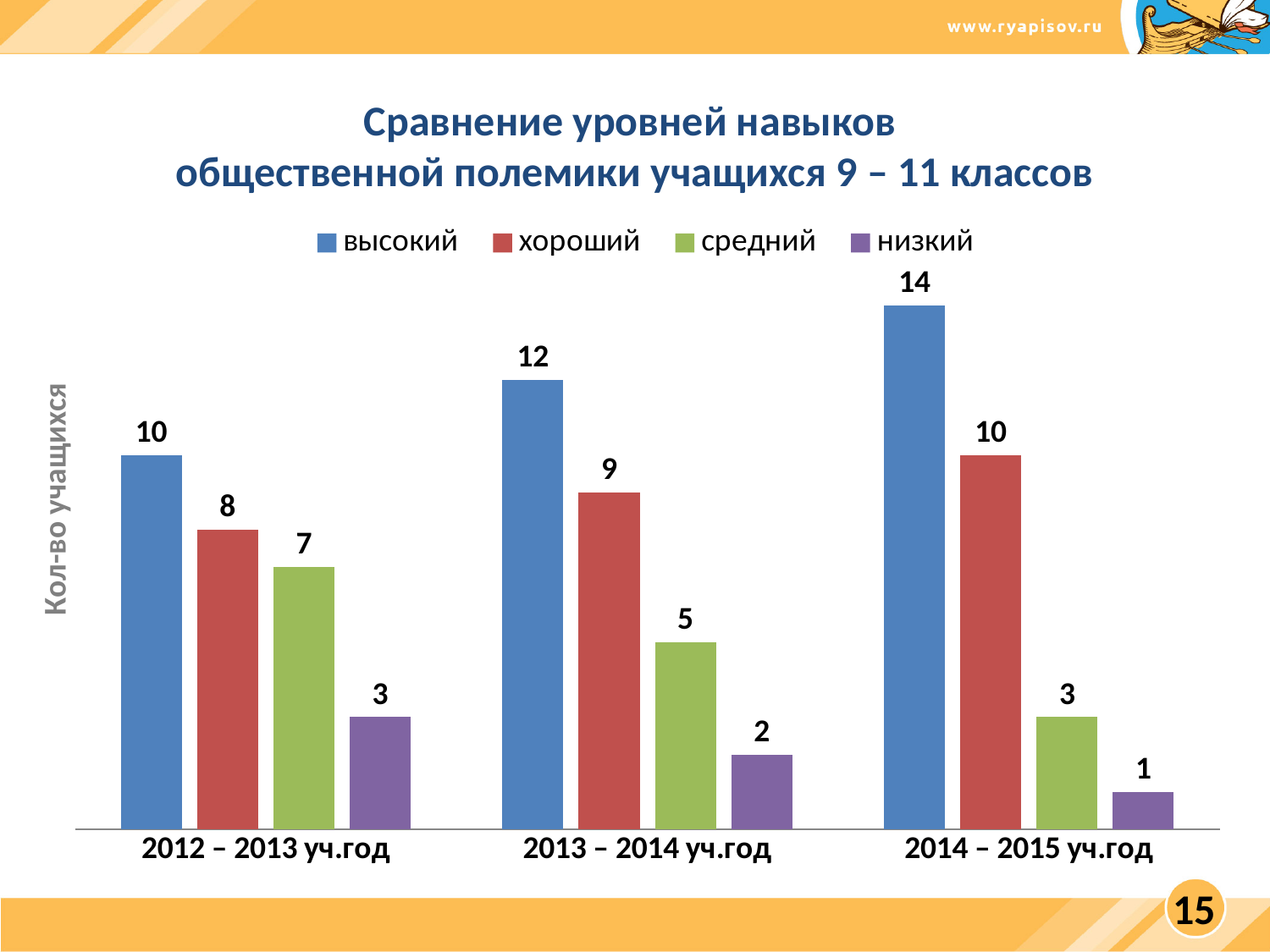
What is the difference between the высокий values for 2014 – 2015 уч.год and 2012 – 2013 уч.год? 4 In which academic year is the value for высокий highest? 2014 – 2015 уч.год What is the value for низкий in 2014 – 2015 уч.год? 1 What is the value for средний in 2013 – 2014 уч.год? 5 Which is larger: хороший in 2013 – 2014 уч.год or хороший in 2014 – 2015 уч.год? хороший in 2014 – 2015 уч.год What is the label of the y axis? Кол-во учащихся What kind of chart is shown on the slide? bar chart What is the value for высокий in 2012 – 2013 уч.год? 10 Does the value for средний rise or fall across the academic years from 2012 – 2013 to 2014 – 2015? fall In which academic year is the value for низкий lowest? 2014 – 2015 уч.год How many academic years are shown on the x axis? 3 How many series does the legend list? 4